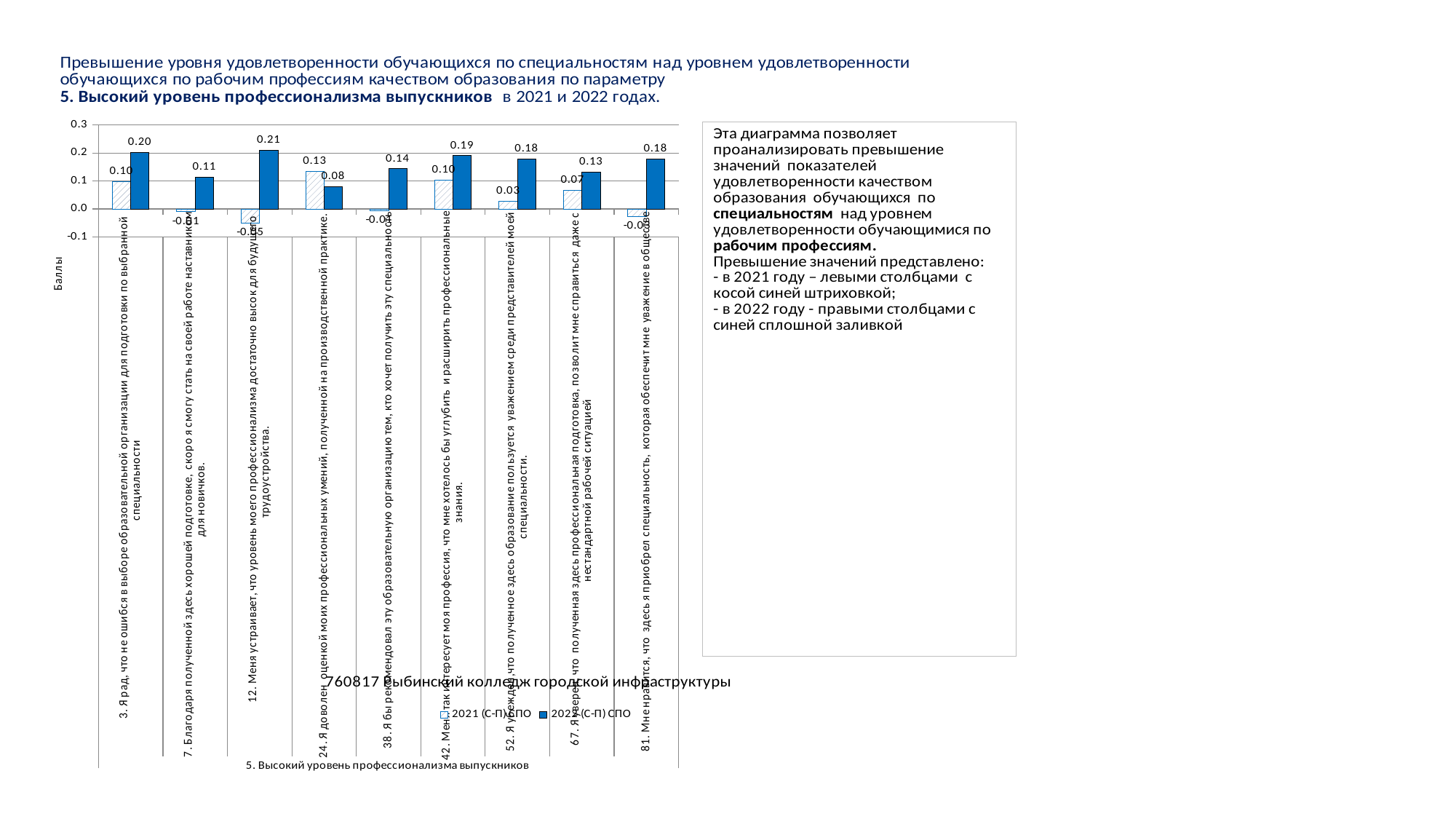
What is the 2021 (С-П) СПО value for statement 52 ("Я убежден, что полученное здесь образование пользуется уважением...")? 0.03 Which statement has the highest 2022 (С-П) СПО value? Statement 12 (Меня устраивает, что уровень моего профессионализма достаточно высок для будущего трудоустройства), 0.21 How many statement categories are plotted along the x axis of the chart? 9 What is the 2021 (С-П) СПО value for statement 24 ("Я доволен оценкой моих профессиональных умений...")? 0.13 What is the 2022 (С-П) СПО value for statement 3 ("Я рад, что не ошибся в выборе образовательной организации...")? 0.20 How many series does the chart legend list? 2 What is the 2022 (С-П) СПО value for statement 12 ("Меня устраивает, что уровень моего профессионализма достаточно высок...")? 0.21 For statement 3, how much higher is the 2022 (С-П) СПО value than the 2021 (С-П) СПО value? 0.10 What kind of chart is shown on the slide? Bar chart Which statement has the lowest 2022 (С-П) СПО value? Statement 24 (Я доволен оценкой моих профессиональных умений, полученной на производственной практике), 0.08 For statement 24, which series has the larger value: 2021 (С-П) СПО or 2022 (С-П) СПО? 2021 (С-П) СПО What are the two series names listed in the chart legend? 2021 (С-П) СПО and 2022 (С-П) СПО